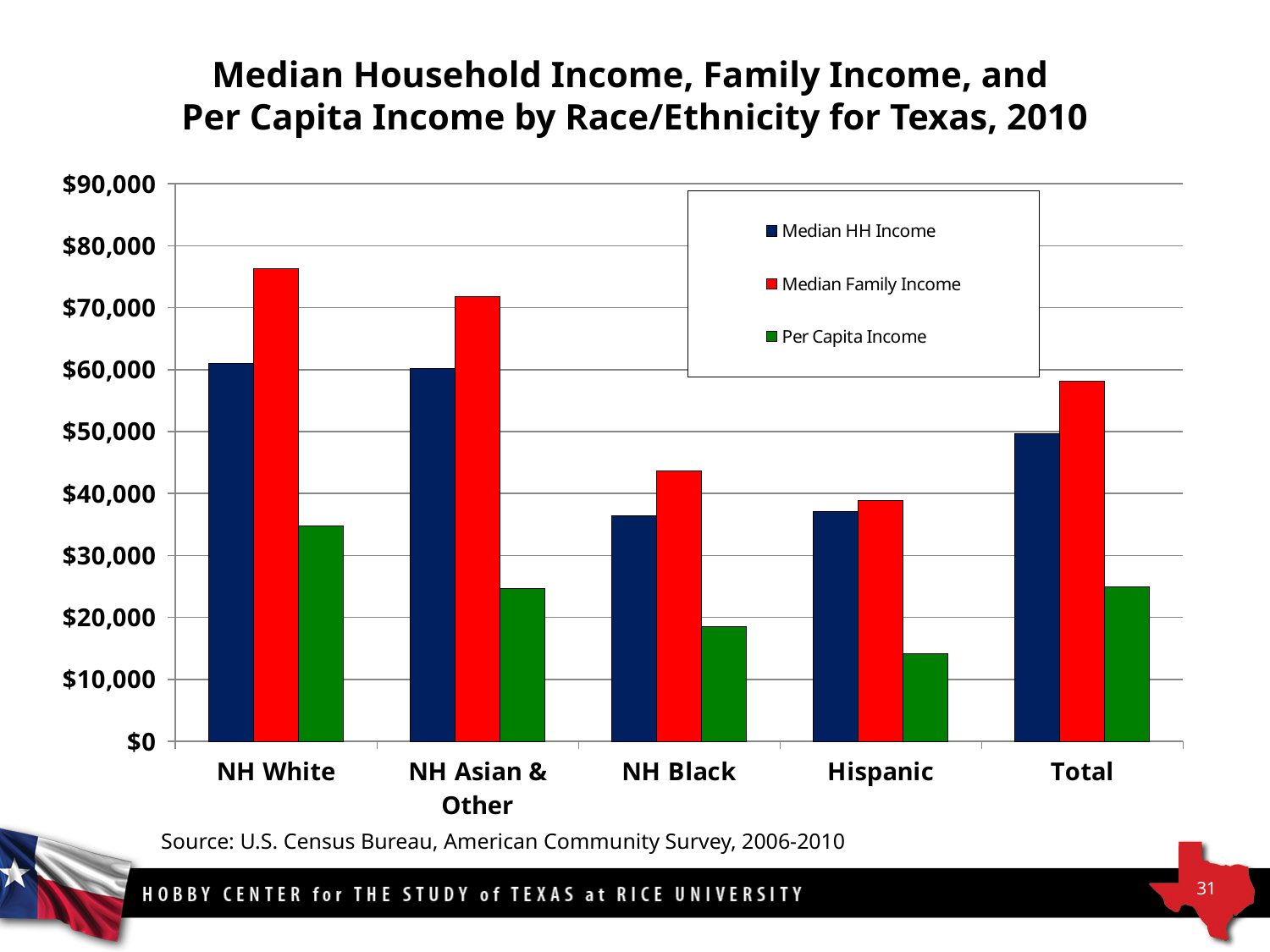
Which is larger, the Median Family Income for NH Black or the Median Family Income for Hispanic? NH Black How many series does the legend list? 3 Is the Median Family Income for NH White greater or less than $70,000? greater Which category has the lowest Per Capita Income? Hispanic How many race/ethnicity categories are shown on the x axis? 5 Which category has the lowest Median Family Income? Hispanic Which series is shown in green in the legend? Per Capita Income What kind of chart is shown on the slide? bar chart Which category has the highest Per Capita Income? NH White Is the Per Capita Income for Hispanic greater or less than $20,000? less Which category has the highest Median Family Income? NH White